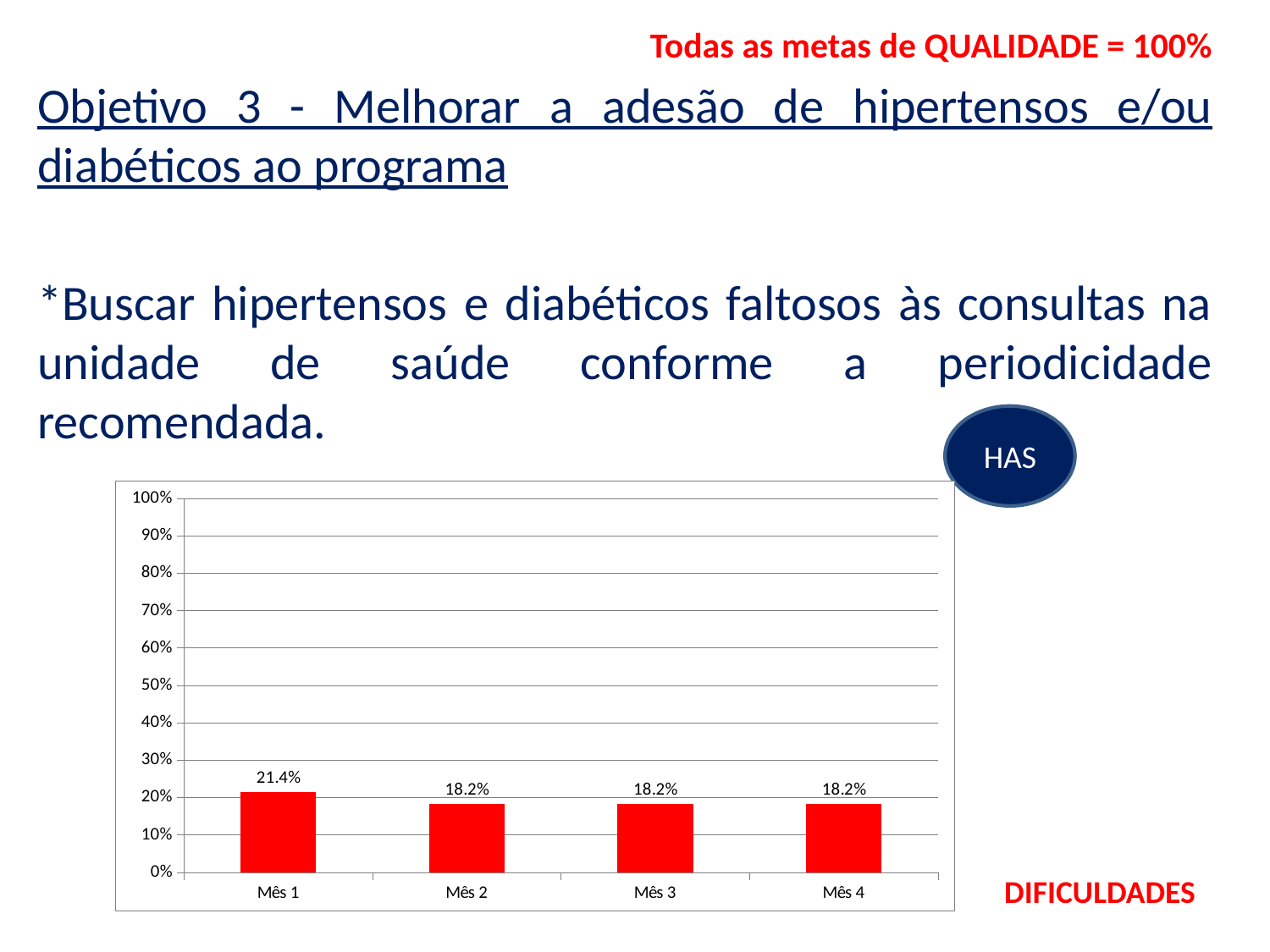
Is the value for Mês 2 greater or less than 20%? less What is the value for Mês 4? 18.2% What is the difference between the values for Mês 1 and Mês 2? 3.2% Which is larger, the value for Mês 1 or the value for Mês 4? Mês 1 Which month has the highest value? Mês 1 What is the value for Mês 3? 18.2% What kind of chart is shown on the slide? bar chart What colour are the bars in the chart? red Do the values rise or fall from Mês 1 to Mês 2? fall What is the value for Mês 1? 21.4% Is the value for Mês 1 greater or less than 20%? greater How many months are shown on the x axis? 4